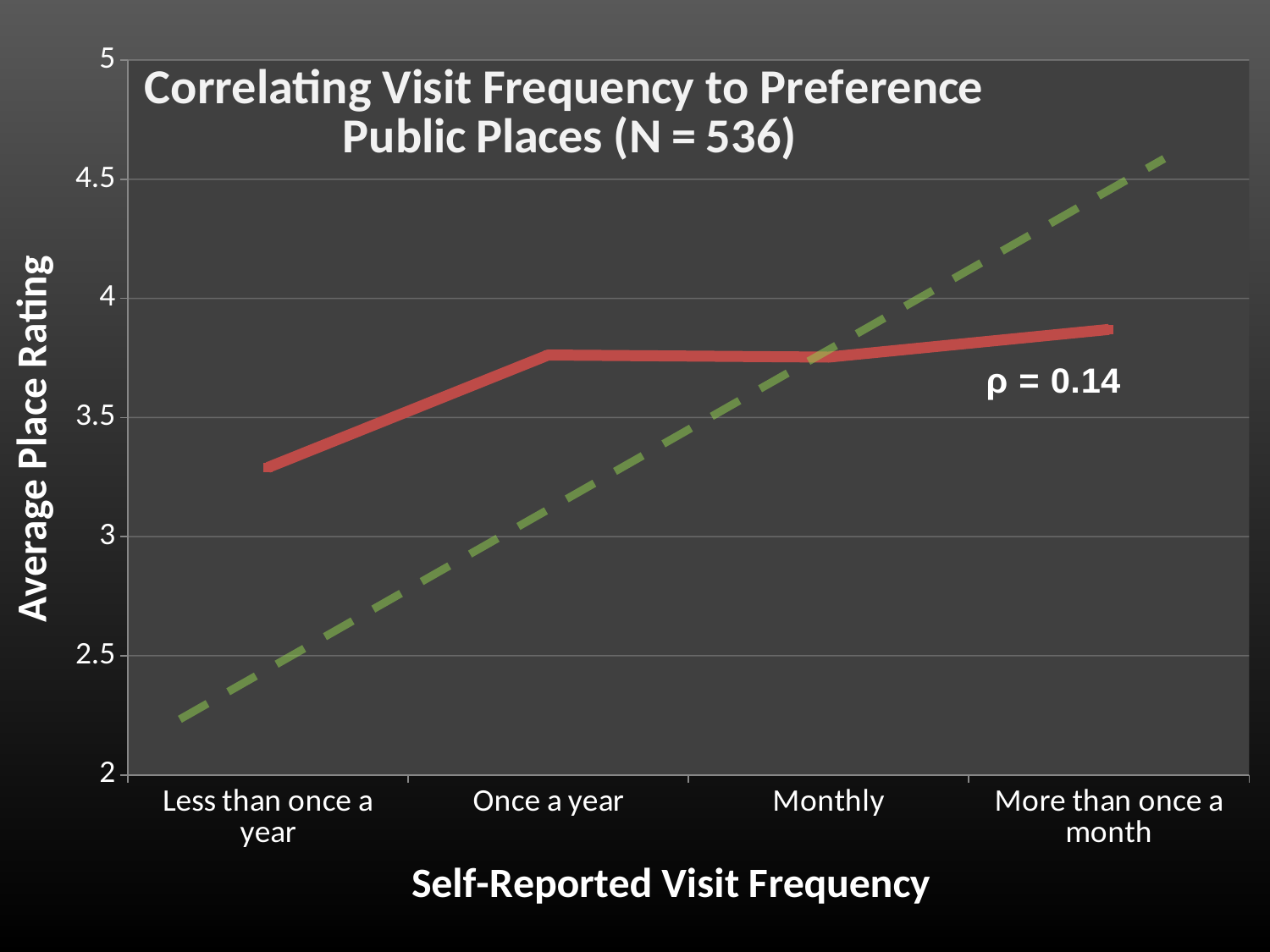
Is the average place rating for 'Once a year' greater or less than 3.5? greater Does the average place rating generally rise or fall as visit frequency increases along the x axis? rise Is the average place rating for 'Less than once a year' greater or less than 3.5? less What kind of chart is shown on the slide? line chart Which has a higher average place rating, 'Less than once a year' or 'Once a year'? Once a year How many visit frequency categories are shown on the x axis? 4 Is the average place rating for 'More than once a month' greater or less than 4? less What is the title of the chart? Correlating Visit Frequency to Preference Public Places (N = 536) What correlation coefficient (ρ) is annotated on the chart? ρ = 0.14 Which visit frequency category has the lowest average place rating? Less than once a year